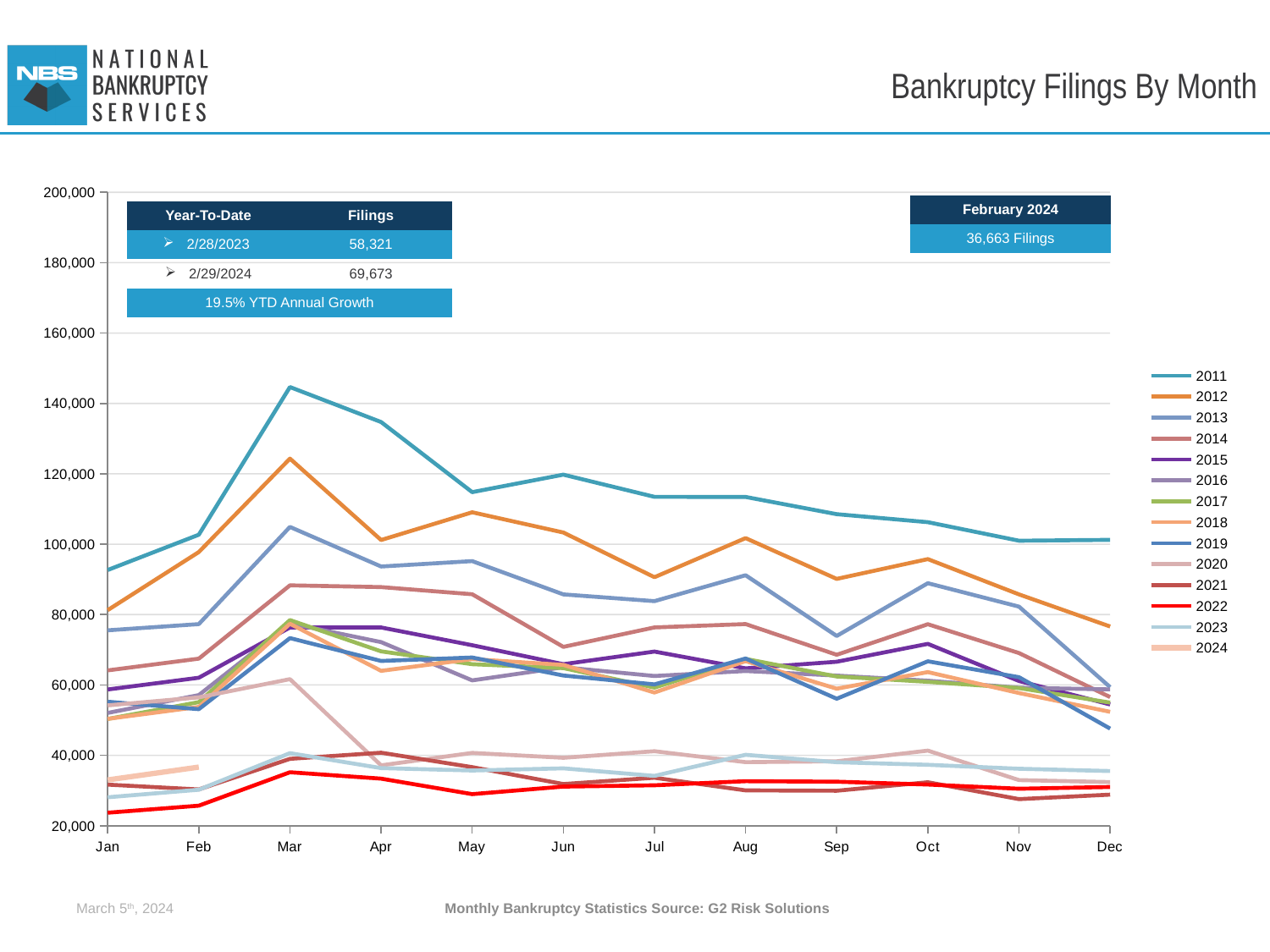
According to the callout box, how many filings were there in February 2024? 36,663 Filings How many months are shown along the x axis? 12 Is the value for 2011 in March greater or less than 140,000? greater How many series does the legend list? 14 What is the difference between the year-to-date filings as of 2/29/2024 and as of 2/28/2023? 11,352 Which year has the lowest filings in January? 2022 Which is larger in January, the value for 2011 or the value for 2012? 2011 What is the year-to-date filings figure as of 2/28/2023 shown in the table? 58,321 What kind of chart is shown on the slide? line chart What is the year-to-date filings figure as of 2/29/2024 shown in the table? 69,673 Is the value for 2020 in April greater or less than 60,000? less Which year has the highest filings in March? 2011